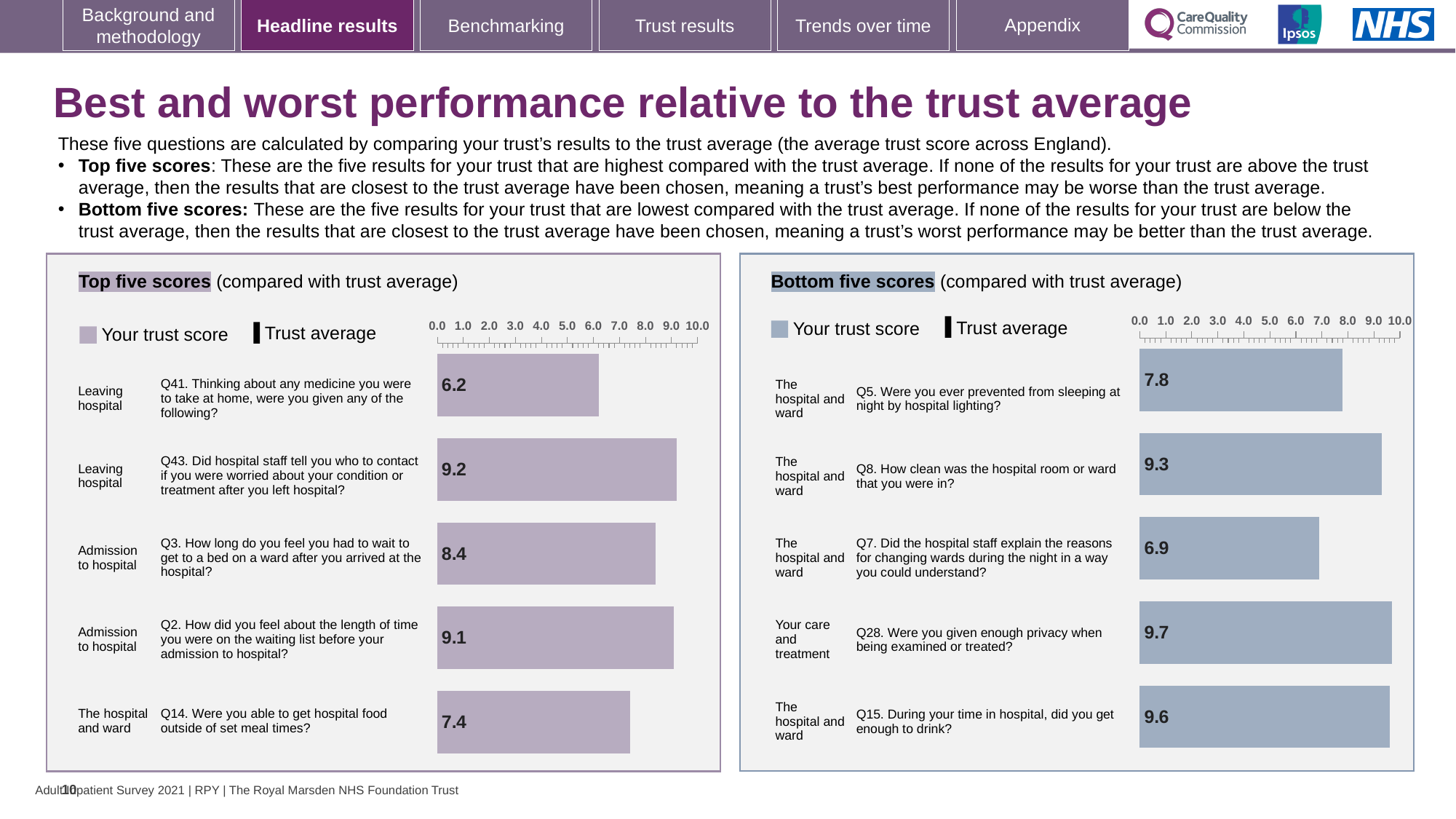
How many series does the legend of the Bottom five scores chart list? 2 In the Top five scores chart, what is the difference between the trust scores for Q43 and Q41? 3.0 In the Bottom five scores chart, which question has the lowest trust score? Q7 What type of chart is used in the Top five scores panel? Bar chart How many questions are shown in the Bottom five scores chart? 5 In the Top five scores chart, which question has the highest trust score? Q43 In the Top five scores chart, what is the trust score for Q3 (wait to get to a bed on a ward)? 8.4 In the Bottom five scores chart, what is the difference between the trust scores for Q8 and Q5? 1.5 In the Bottom five scores chart, what is the trust score for Q28 (enough privacy when being examined or treated)? 9.7 In the Top five scores chart, which has the larger trust score, Q14 or Q2? Q2 In the Bottom five scores chart, what is the trust score for Q5 (prevented from sleeping by hospital lighting)? 7.8 In the Top five scores chart, what is the trust score for Q41 (medicine to take at home)? 6.2